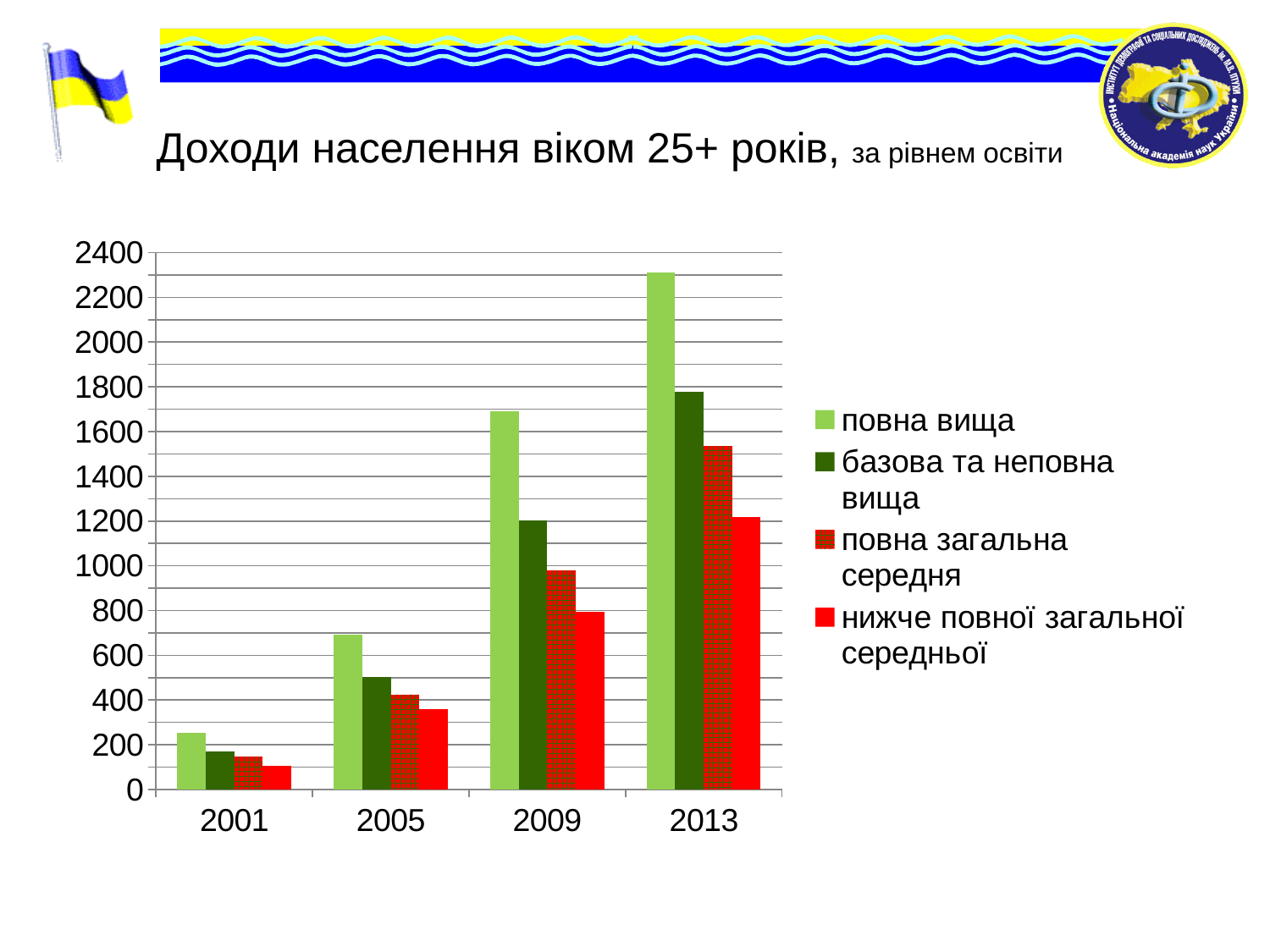
In which year is the value for "нижче повної загальної середньої" lowest? 2001 Is the value for "нижче повної загальної середньої" in 2013 greater or less than 1400? less Is the value for "повна вища" in 2013 greater or less than 2000? greater How many series does the legend list? 4 Which series is shown in light green in the legend? повна вища In which year is the value for "повна вища" highest? 2013 Is the value for "повна вища" in 2009 greater or less than 1600? greater Do the values for "повна вища" rise or fall from 2001 to 2013? rise How many years are shown on the x axis? 4 What kind of chart is shown on the slide? bar chart In 2013, which is larger: "базова та неповна вища" or "повна загальна середня"? базова та неповна вища